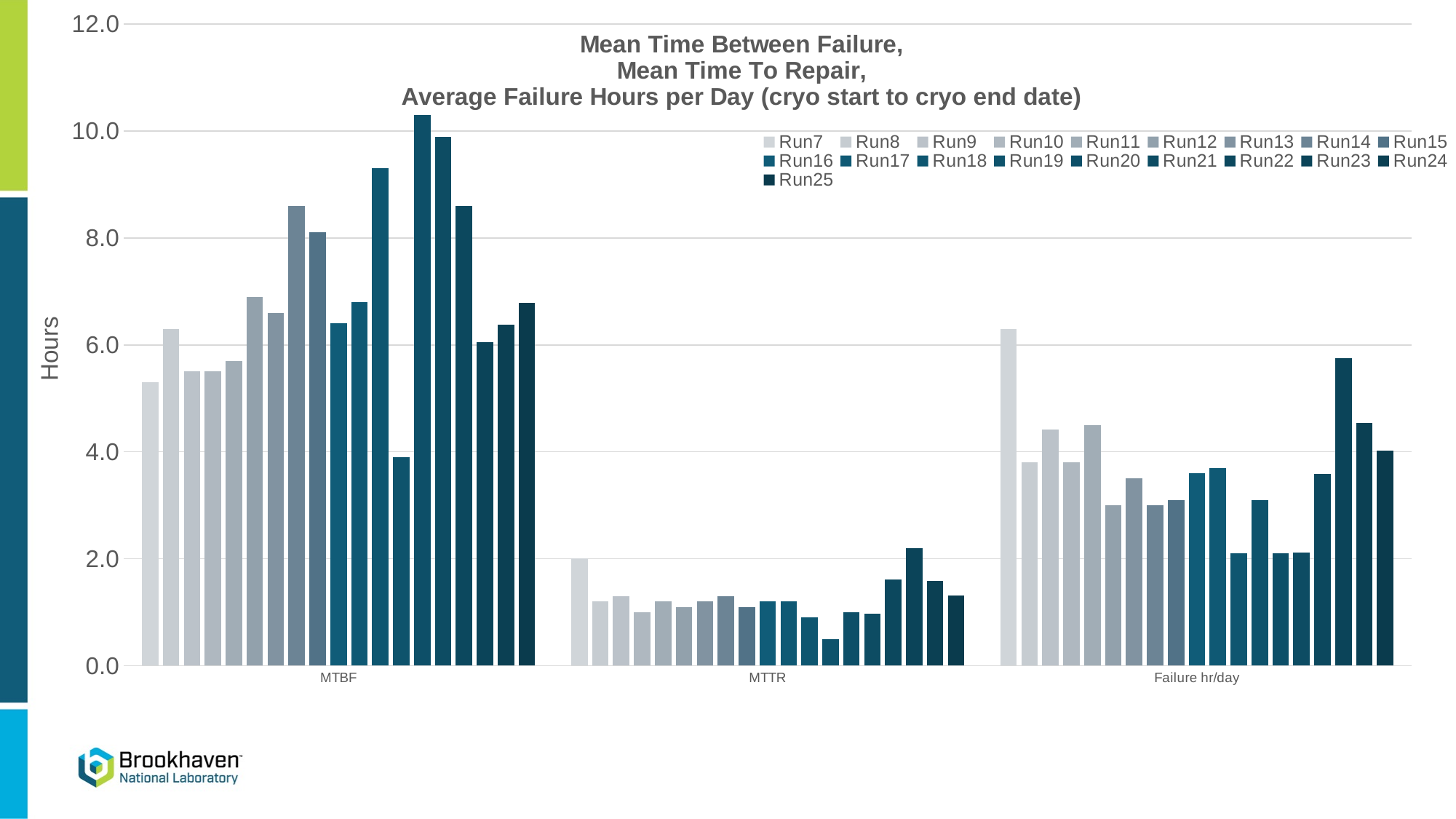
Which category contains the tallest bar in the chart? MTBF Is the tallest bar in the MTBF group greater or less than 10.0? greater Is the leftmost (Run7) bar in the MTBF group greater or less than 6.0? less What is the first series listed in the legend? Run7 How many categories are shown on the x axis of the chart? 3 Is the leftmost (Run7) bar in the Failure hr/day group greater or less than 6.0? greater What is the label of the y axis? Hours What kind of chart is shown on the slide? bar chart Which category has the lowest bars overall? MTTR Is the tallest bar in the Failure hr/day group larger or smaller than the tallest bar in the MTBF group? smaller How many series does the chart's legend list? 19